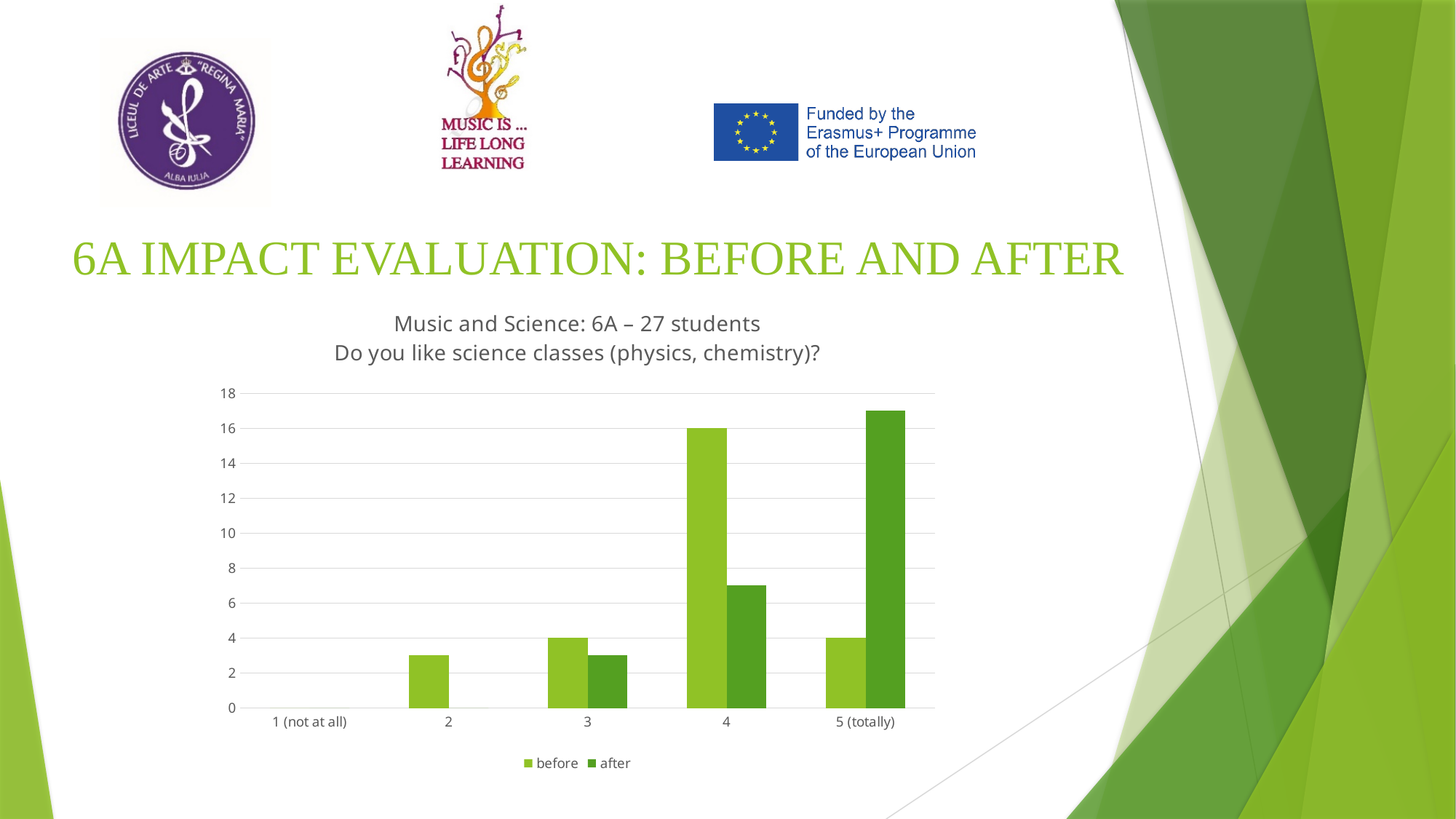
Is the 'after' value for '5 (totally)' greater or less than 16? greater How many categories are shown on the x axis? 5 What kind of chart is shown on the slide? bar chart Which category has the highest 'after' value? 5 (totally) What question is the chart about, according to its title? Do you like science classes (physics, chemistry)? Is the 'after' value for category 4 greater or less than 8? less Which category has the highest 'before' value? 4 What is the 'before' value for category 4? 16 How many series does the legend list? 2 What is the 'before' value for category '5 (totally)'? 4 For category 4, which is larger, the 'before' value or the 'after' value? before What is the 'before' value for category 3? 4